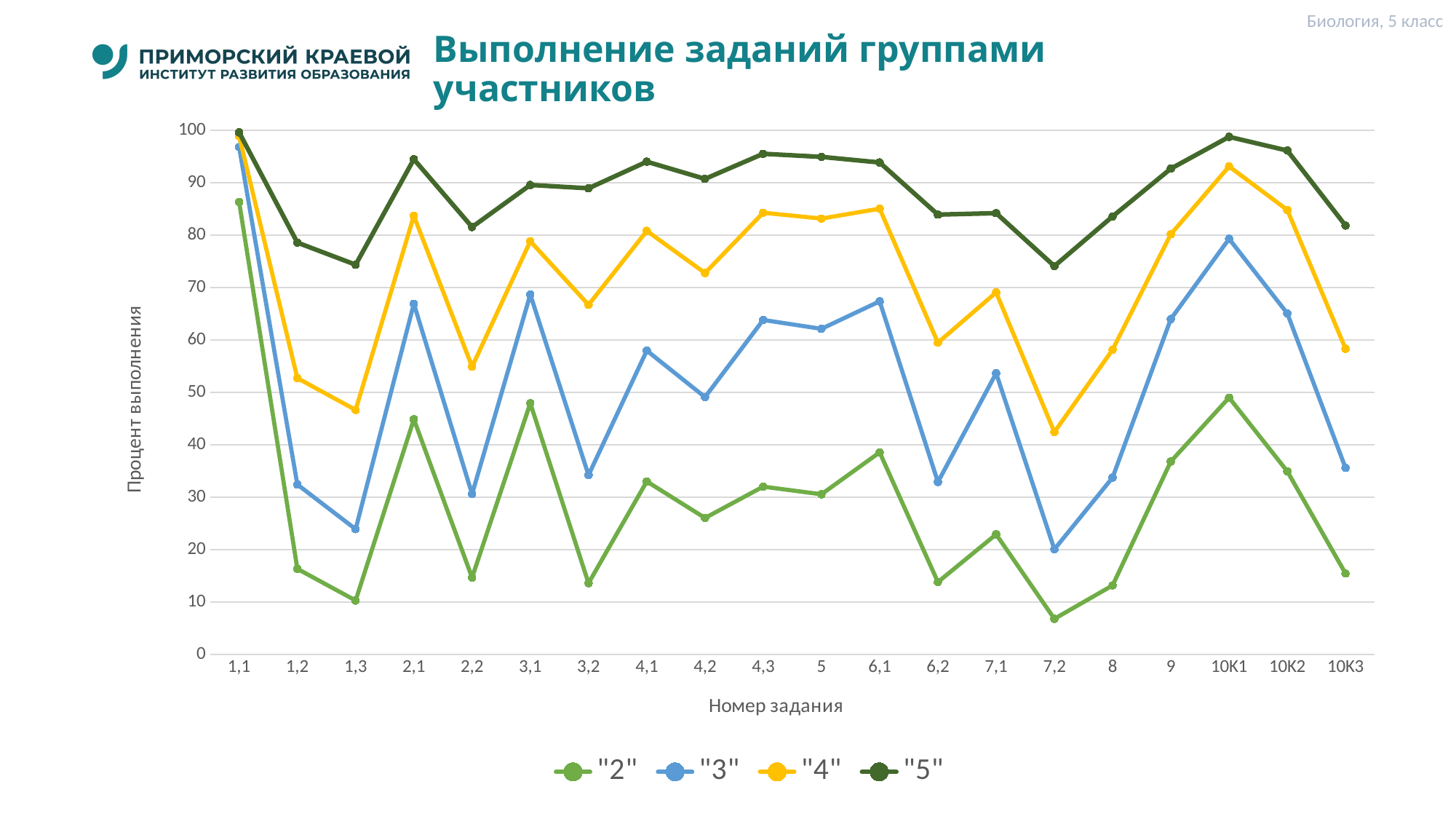
How many series does the legend list? 4 What kind of chart is shown on the slide? line chart What is the title of the chart? Выполнение заданий группами участников Which is larger for the "5" series: the value for task 2,1 or the value for task 2,2? 2,1 For which task number does the "2" series reach its highest value? 1,1 Is the value of the "5" series for task 1,3 greater or less than 80? less Is the value of the "5" series for task 10К1 greater or less than 90? greater For which task number does the "2" series reach its lowest value? 7,2 How many task numbers are shown along the x axis? 20 Is the value of the "2" series for task 7,2 greater or less than 10? less For which task number does the "3" series reach its lowest value? 7,2 What is the label of the y axis? Процент выполнения